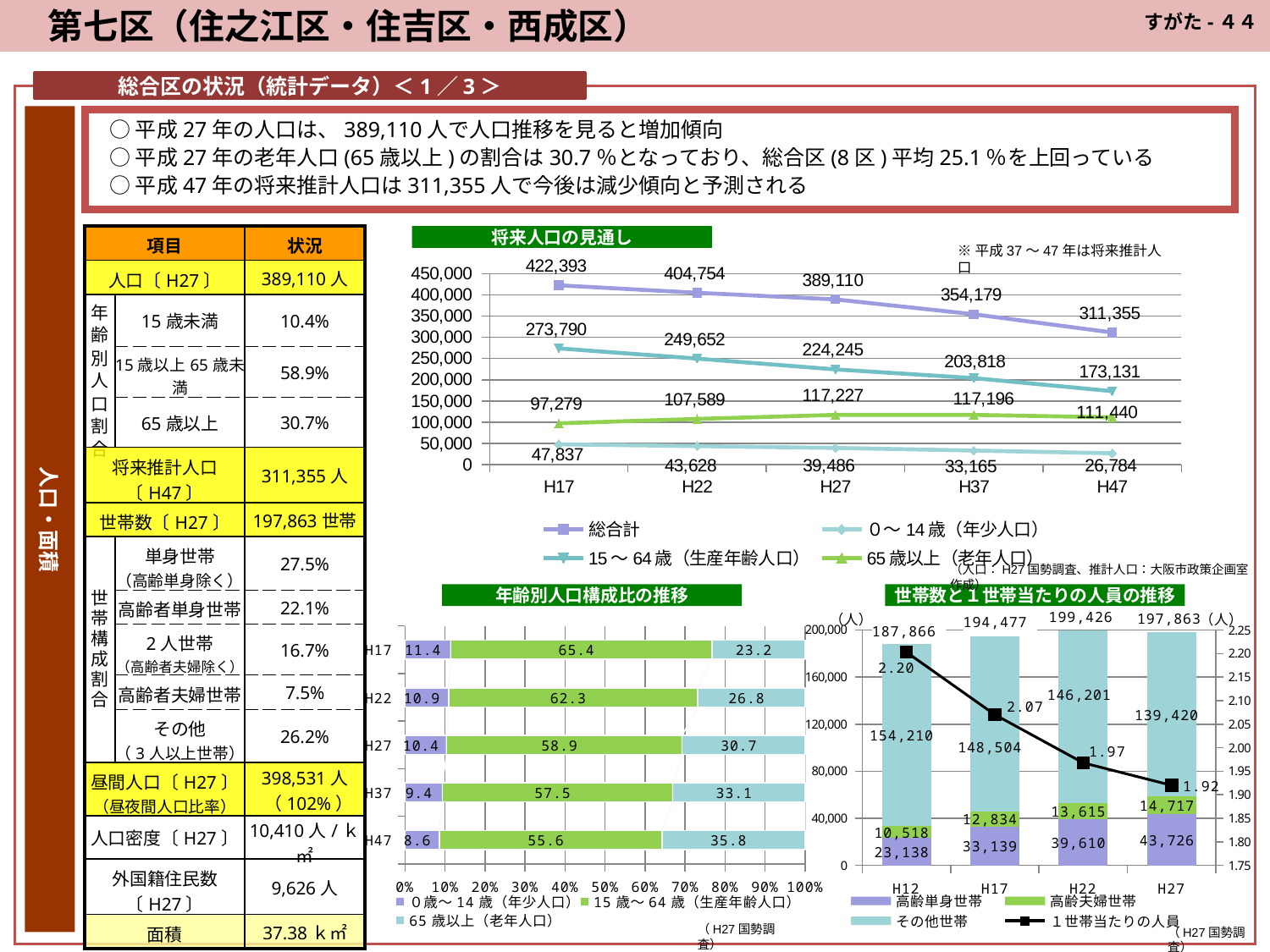
In the 世帯数と１世帯当たりの人員の推移 chart, what is the １世帯当たりの人員 value for H12? 2.20 What kind of chart is the 将来人口の見通し chart? line chart In the 将来人口の見通し chart, what is the difference between the 総合計 values for H17 and H47? 111,038 In the 将来人口の見通し chart, in which year is the 0～14歳（年少人口） value lowest? H47 In the 将来人口の見通し chart, what is the value of 15～64歳（生産年齢人口） for H27? 224,245 In the 世帯数と１世帯当たりの人員の推移 chart, what is the 高齢単身世帯 value for H27? 43,726 In the 年齢別人口構成比の推移 chart, what is the 65歳以上（老年人口） share for H37? 33.1 In the 世帯数と１世帯当たりの人員の推移 chart, which year has the highest total number of households? H22 How many series does the legend of the 将来人口の見通し chart list? 4 In the 将来人口の見通し chart, does the 15～64歳（生産年齢人口） series rise or fall from H17 to H47? fall In the 年齢別人口構成比の推移 chart, how many years (bars) are shown? 5 In the 将来人口の見通し chart, what is the 総合計 value for H47? 311,355